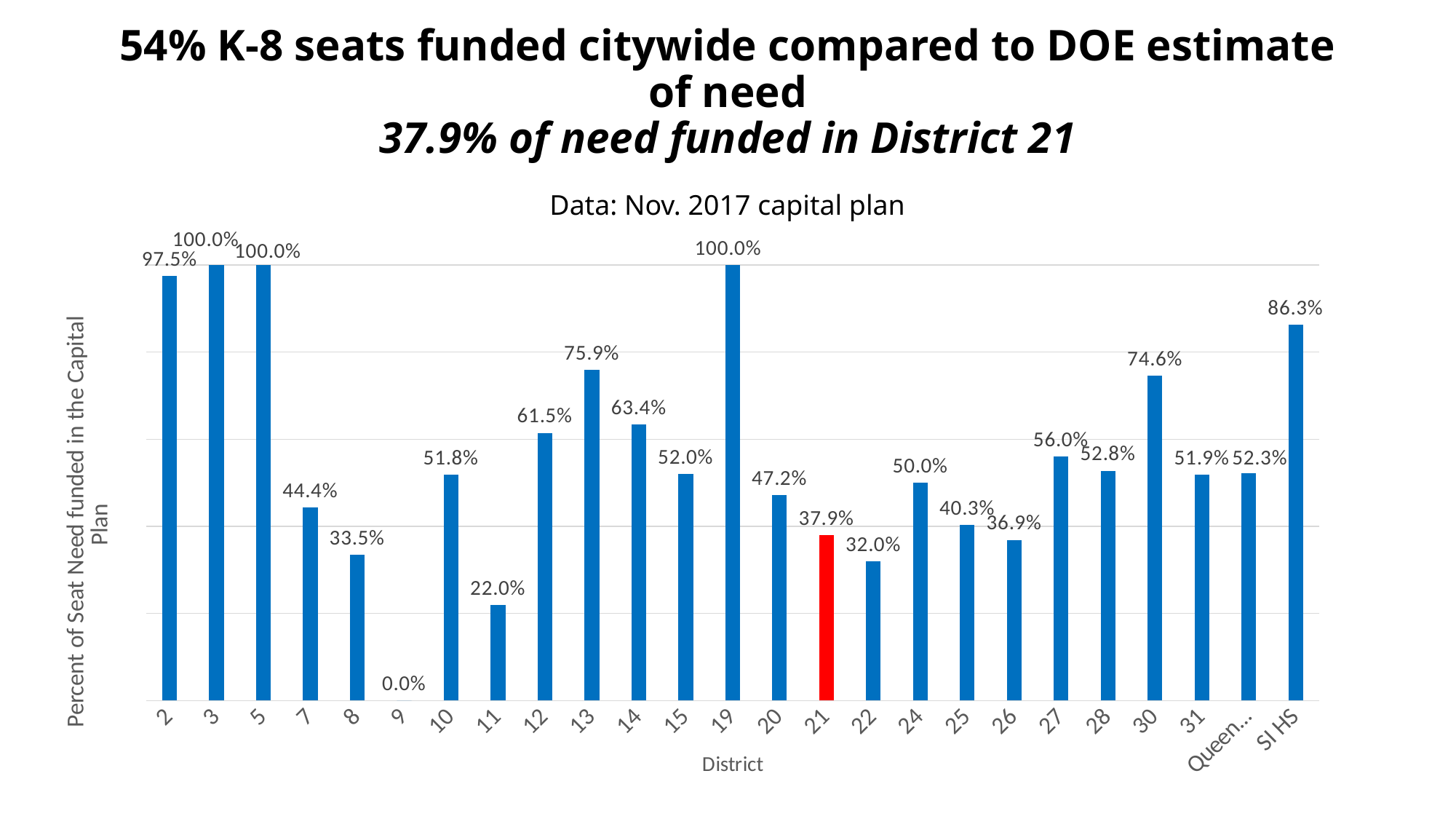
What is the value for District 21? 37.9% Which is larger, the value for District 14 or the value for District 12? District 14 What is the difference between the values for District 30 and District 21? 36.7% What kind of chart is shown on the slide? Bar chart What is the value for District 11? 22.0% What is the value for District 13? 75.9% Which district's bar is coloured red? 21 What is the value for SI HS? 86.3% What is the difference between the values for District 2 and District 8? 64.0% Which district has the lowest value? 9 Which is larger, the value for District 22 or the value for District 26? District 26 How many categories are shown on the x axis? 25